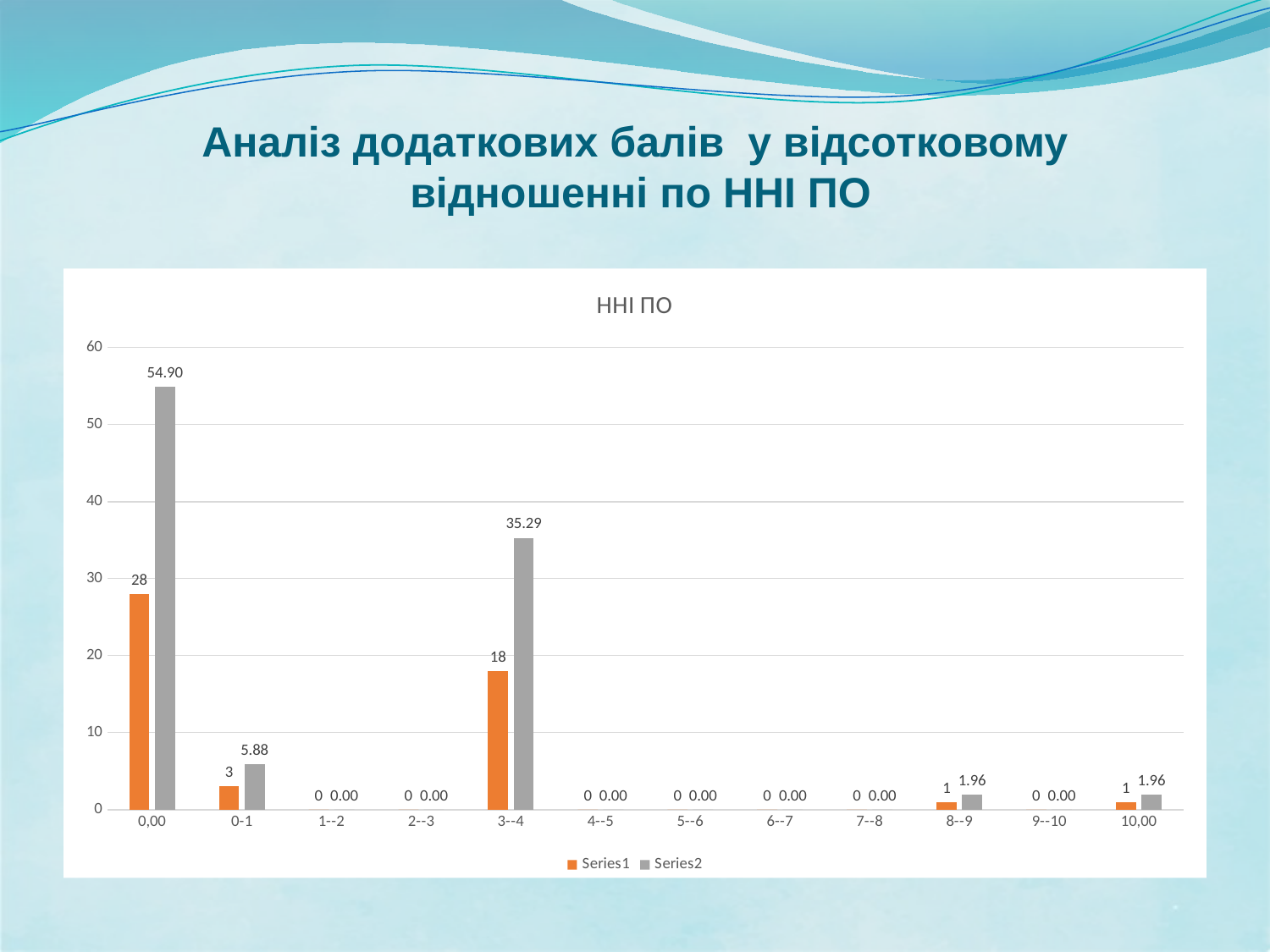
What is the Series1 value for the category 8--9? 1 What is the Series1 value for the category 3--4? 18 What is the Series2 value for the category 0,00? 54.90 How many series does the legend list? 2 What is the difference between the Series2 values for 0,00 and 3--4? 19.61 What type of chart is shown on the slide? bar chart Which is larger: the Series2 value for 0-1 or the Series2 value for 8--9? 0-1 Is the Series2 value for 3--4 greater or less than 30? greater What is the Series2 value for the category 0-1? 5.88 What is the difference between the Series1 values for 0,00 and 3--4? 10 Which category has the highest Series2 value? 0,00 How many categories are shown on the x axis? 12